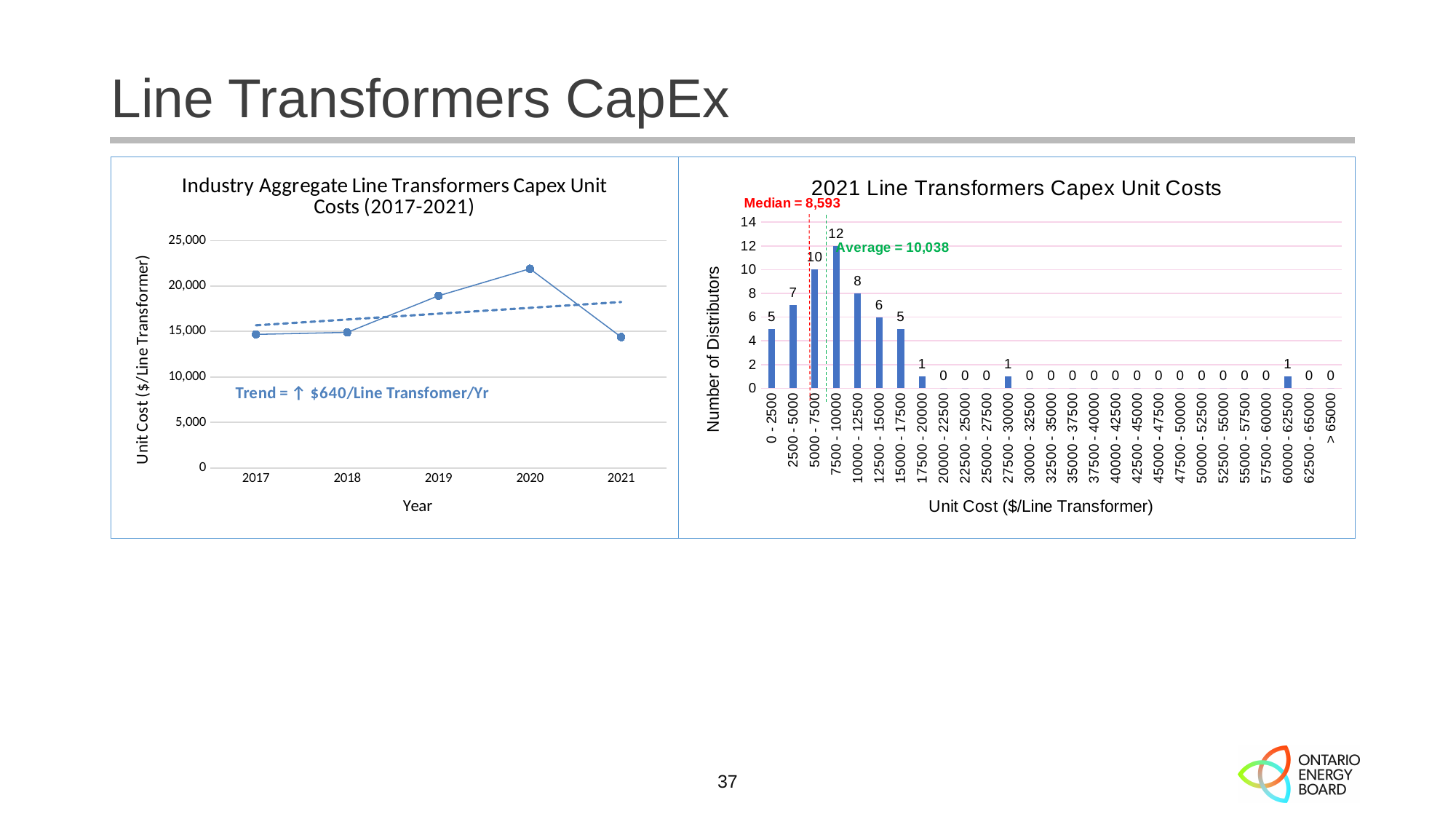
On the right chart (2021 Line Transformers Capex Unit Costs), what is the difference between the number of distributors in the 5000 - 7500 bin and the 12500 - 15000 bin? 4 What kind of chart is the right chart (2021 Line Transformers Capex Unit Costs)? bar chart On the right chart (2021 Line Transformers Capex Unit Costs), which bin has more distributors: 2500 - 5000 or 10000 - 12500? 10000 - 12500 On the left chart (Industry Aggregate Line Transformers Capex Unit Costs), how many years are plotted? 5 On the right chart (2021 Line Transformers Capex Unit Costs), what is the median value shown? 8,593 What kind of chart is the left chart (Industry Aggregate Line Transformers Capex Unit Costs)? line chart On the left chart (Industry Aggregate Line Transformers Capex Unit Costs), which year has the highest unit cost? 2020 On the right chart (2021 Line Transformers Capex Unit Costs), what is the average value shown? 10,038 On the right chart (2021 Line Transformers Capex Unit Costs), which unit cost bin has the most distributors? 7500 - 10000 On the right chart (2021 Line Transformers Capex Unit Costs), how many distributors are in the 7500 - 10000 unit cost bin? 12 On the right chart (2021 Line Transformers Capex Unit Costs), how many distributors are in the 0 - 2500 bin? 5 On the left chart (Industry Aggregate Line Transformers Capex Unit Costs), is the unit cost for 2020 greater or less than 20,000? greater